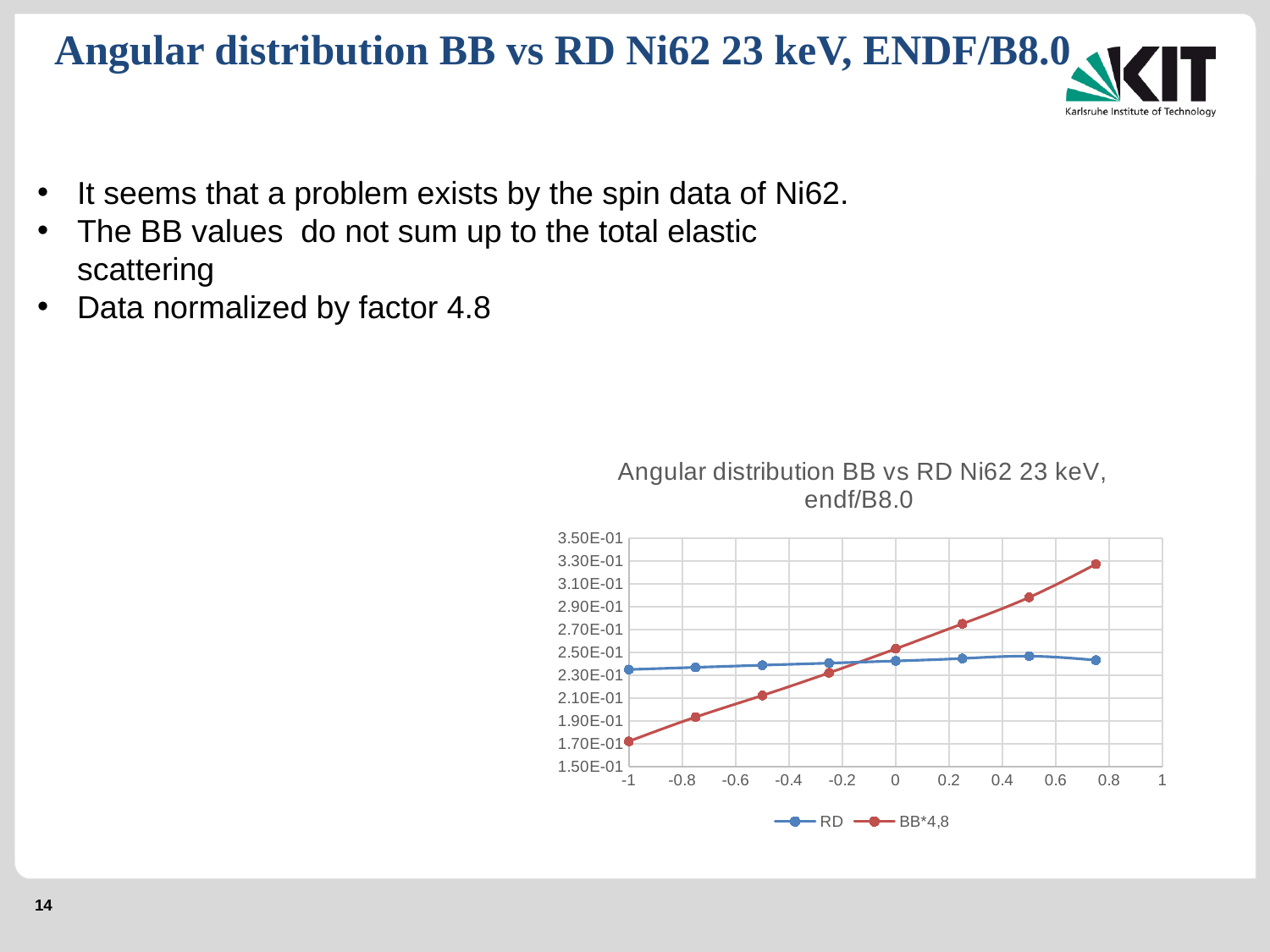
At which x value does the BB*4,8 series have its lowest value? -1 Is the value of BB*4,8 at x = -1 greater or less than 1.90E-01? less Is the value of BB*4,8 at x = 0.75 greater or less than 3.10E-01? greater Which colour is used for the RD series line? blue Do the BB*4,8 values rise or fall as x increases from -1 to 0.75? rise How many series does the chart legend list? 2 What kind of chart is shown on the slide? line chart At x = -1, which series has the larger value, RD or BB*4,8? RD At which x value does the BB*4,8 series reach its highest value? 0.75 What are the names of the two series in the legend? RD and BB*4,8 At x = 0.75, which series has the larger value, RD or BB*4,8? BB*4,8 How many data points are plotted for the BB*4,8 series? 8